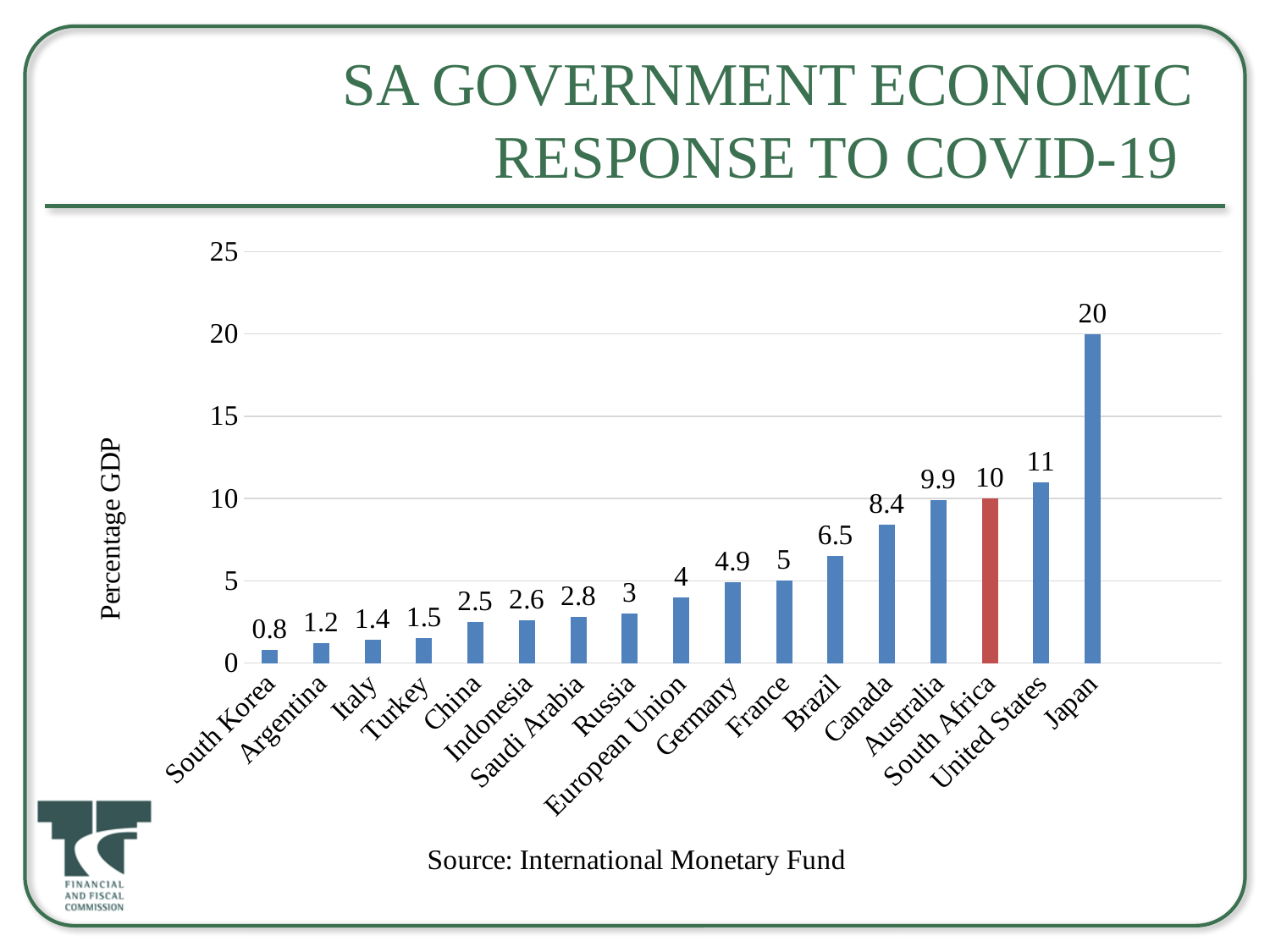
What is the difference between the values for South Africa and Australia? 0.1 Which bar is coloured red rather than blue? South Africa Which is larger, the value for Brazil or the value for France? Brazil What is the value for South Africa? 10 What is the difference between the values for Japan and the United States? 9 What is the value for Germany? 4.9 What kind of chart is shown on the slide? Bar chart What is the value for Canada? 8.4 Do the values rise or fall from left to right along the x axis? Rise How many countries or regions are shown on the x axis? 17 Which country has the highest value? Japan Which country has the lowest value? South Korea